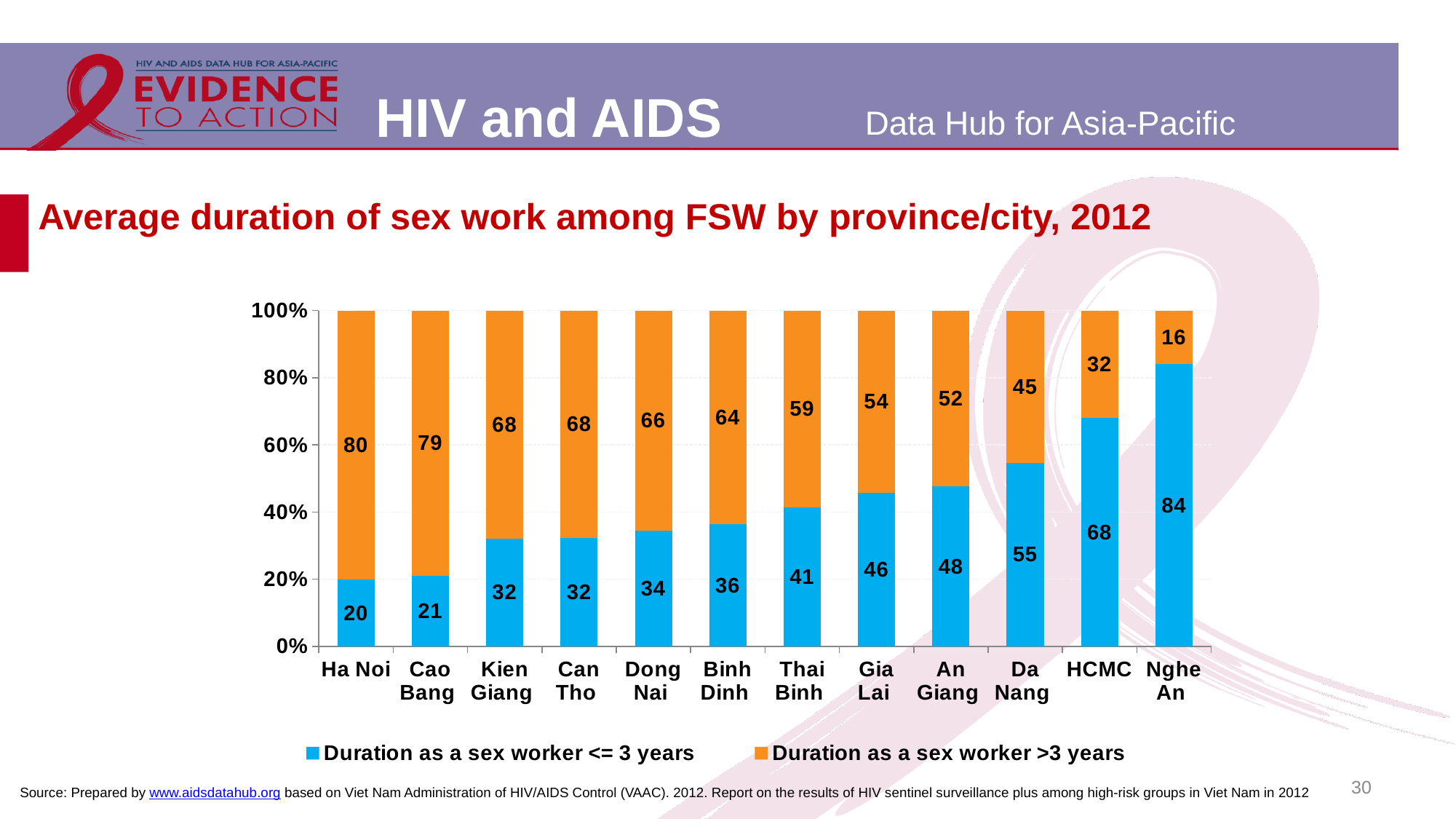
Which province/city has the lowest value for 'Duration as a sex worker >3 years'? Nghe An What is the value for 'Duration as a sex worker <= 3 years' for Ha Noi? 20 How many series does the legend list? 2 Does the 'Duration as a sex worker <= 3 years' value rise or fall from Ha Noi to Nghe An along the x axis? Rise How many provinces/cities are shown on the x axis? 12 Which colour represents 'Duration as a sex worker >3 years' in the chart? Orange Which is larger: the 'Duration as a sex worker <= 3 years' value for Gia Lai or for Binh Dinh? Gia Lai What is the difference between the 'Duration as a sex worker >3 years' values for Ha Noi and Thai Binh? 21 What is the value for 'Duration as a sex worker <= 3 years' for Da Nang? 55 Which province/city has the highest value for 'Duration as a sex worker <= 3 years'? Nghe An What is the value for 'Duration as a sex worker >3 years' for HCMC? 32 What kind of chart is shown on the slide? Stacked bar chart